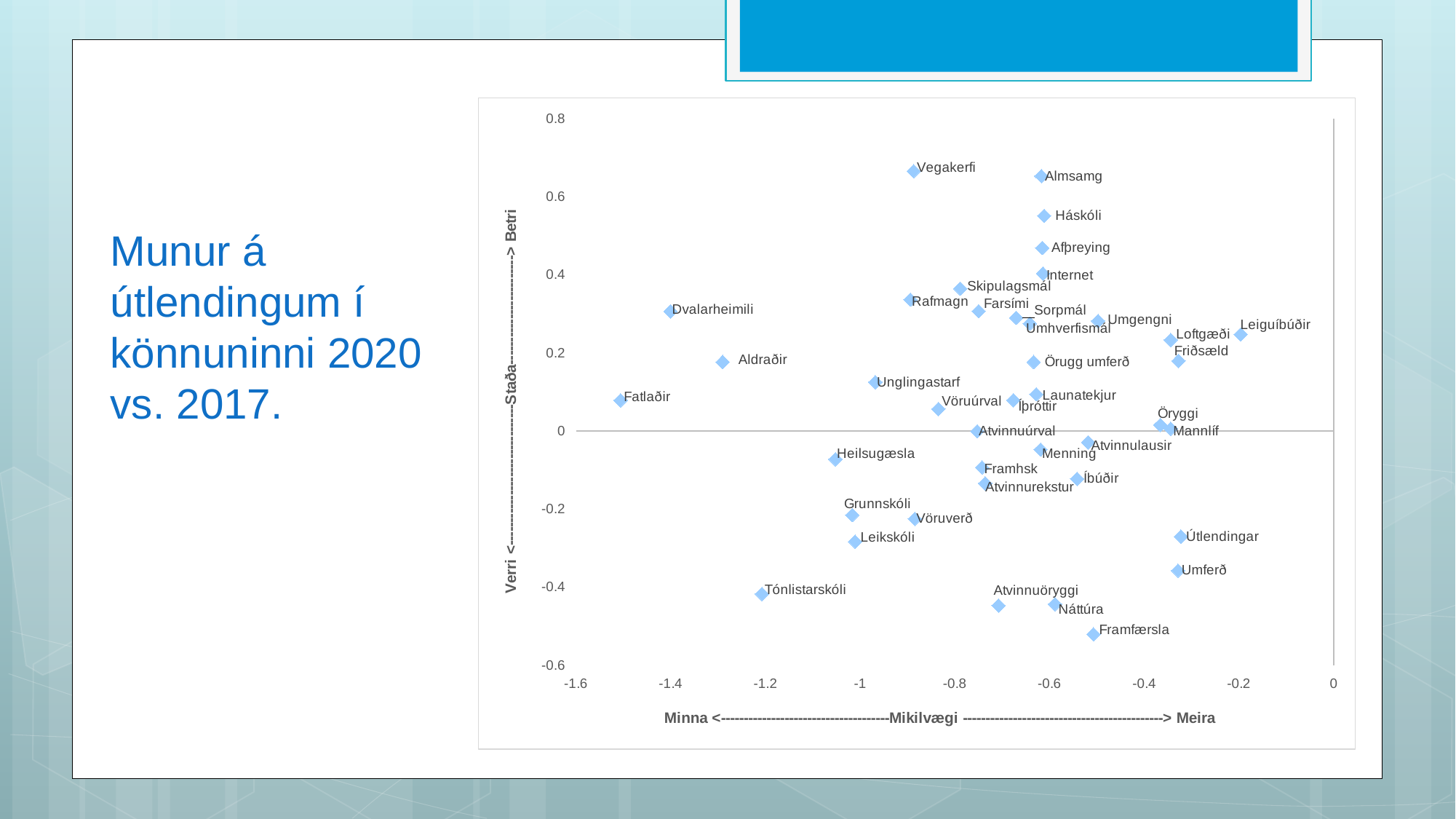
Which point is furthest left on the horizontal (Mikilvægi) axis? Fatlaðir Is the horizontal-axis value for Fatlaðir greater or less than -1.4? less Which point is lowest on the vertical (Staða) axis? Framfærsla What is the title text shown to the left of the chart? Munur á útlendingum í könnuninni 2020 vs. 2017. Is the vertical-axis value for Háskóli greater or less than 0.4? greater Which point is further right on the horizontal axis, Fatlaðir or Leiguíbúðir? Leiguíbúðir Is the vertical-axis value for Framfærsla greater or less than -0.4? less What kind of chart is shown on the slide? scatter chart Which point is furthest right on the horizontal (Mikilvægi) axis? Leiguíbúðir Which point is higher on the vertical axis, Vegakerfi or Aldraðir? Vegakerfi